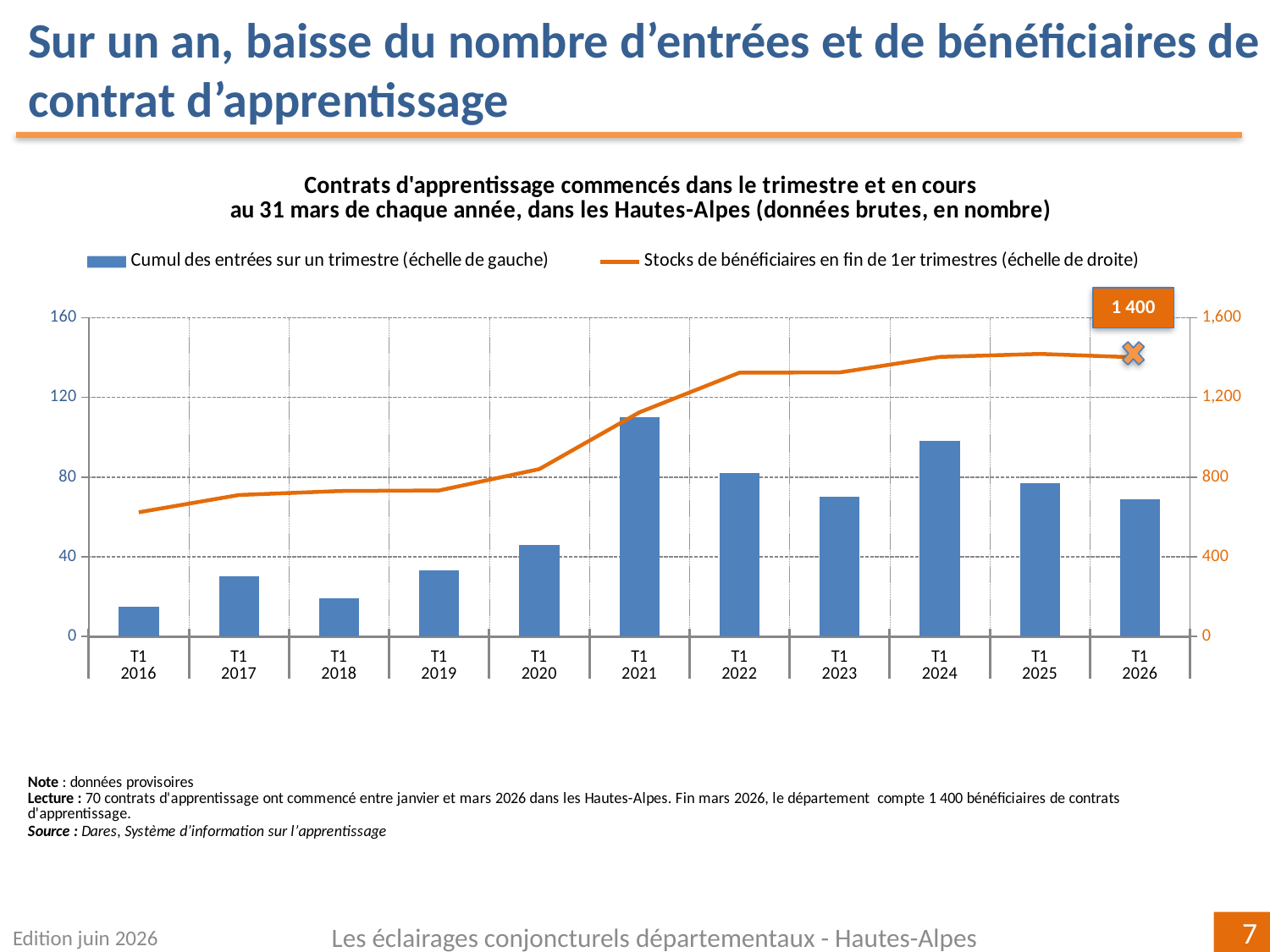
How many series does the legend list? 2 What is the highest tick value shown on the right-hand axis? 1,600 Which bar is taller, T1 2025 or T1 2026? T1 2025 In which quarter is the bar for 'Cumul des entrées sur un trimestre' the highest? T1 2021 What kind of chart is shown on the slide? A combined bar and line chart What is the value of the stock of beneficiaries (Stocks de bénéficiaires) at T1 2026? 1 400 Is the stock of beneficiaries at T1 2016 greater or less than 800 on the right-hand scale? less Does the line for stocks of beneficiaries generally rise or fall from T1 2016 to T1 2025? rise How many quarters (T1 points) are shown along the x axis? 11 Is the bar value for T1 2021 greater or less than 80? greater Which bar is taller, T1 2024 or T1 2025? T1 2024 Is the bar value for T1 2016 greater or less than 40? less